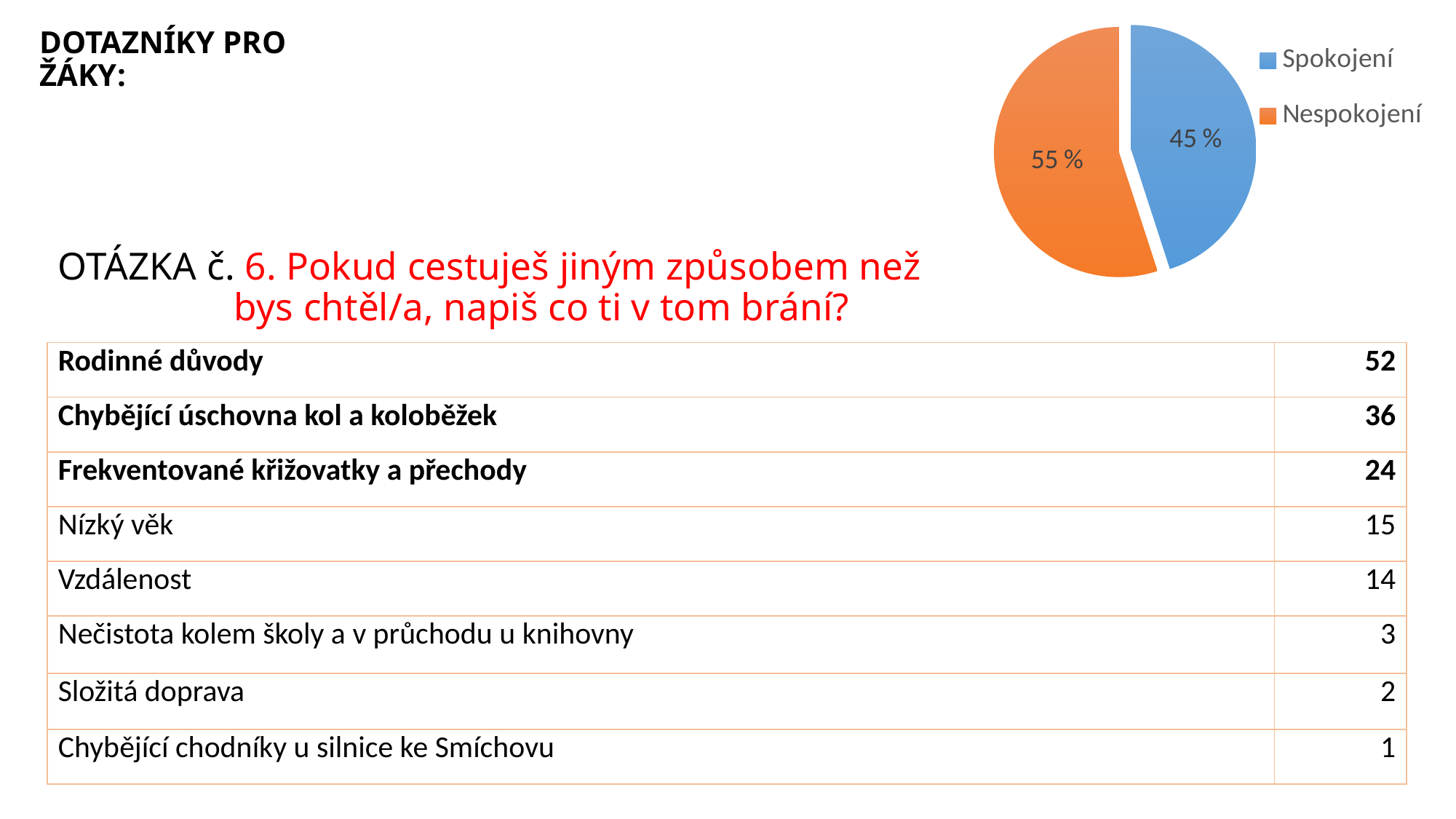
What share of the pie does the Spokojení slice represent? 45 % Which slice of the pie chart is the smallest? Spokojení What is the value for Nespokojení in the pie chart? 55 % Which is larger in the pie chart, Spokojení or Nespokojení? Nespokojení What colour is the Nespokojení slice in the pie chart? orange What kind of chart is shown on the slide? pie chart What colour is the Spokojení slice in the pie chart? blue Which slice of the pie chart is the largest? Nespokojení How many entries does the pie chart legend list? 2 What is the difference between the Nespokojení and Spokojení values in the pie chart? 10 % What is the value for Spokojení in the pie chart? 45 % How many slices does the pie chart have? 2